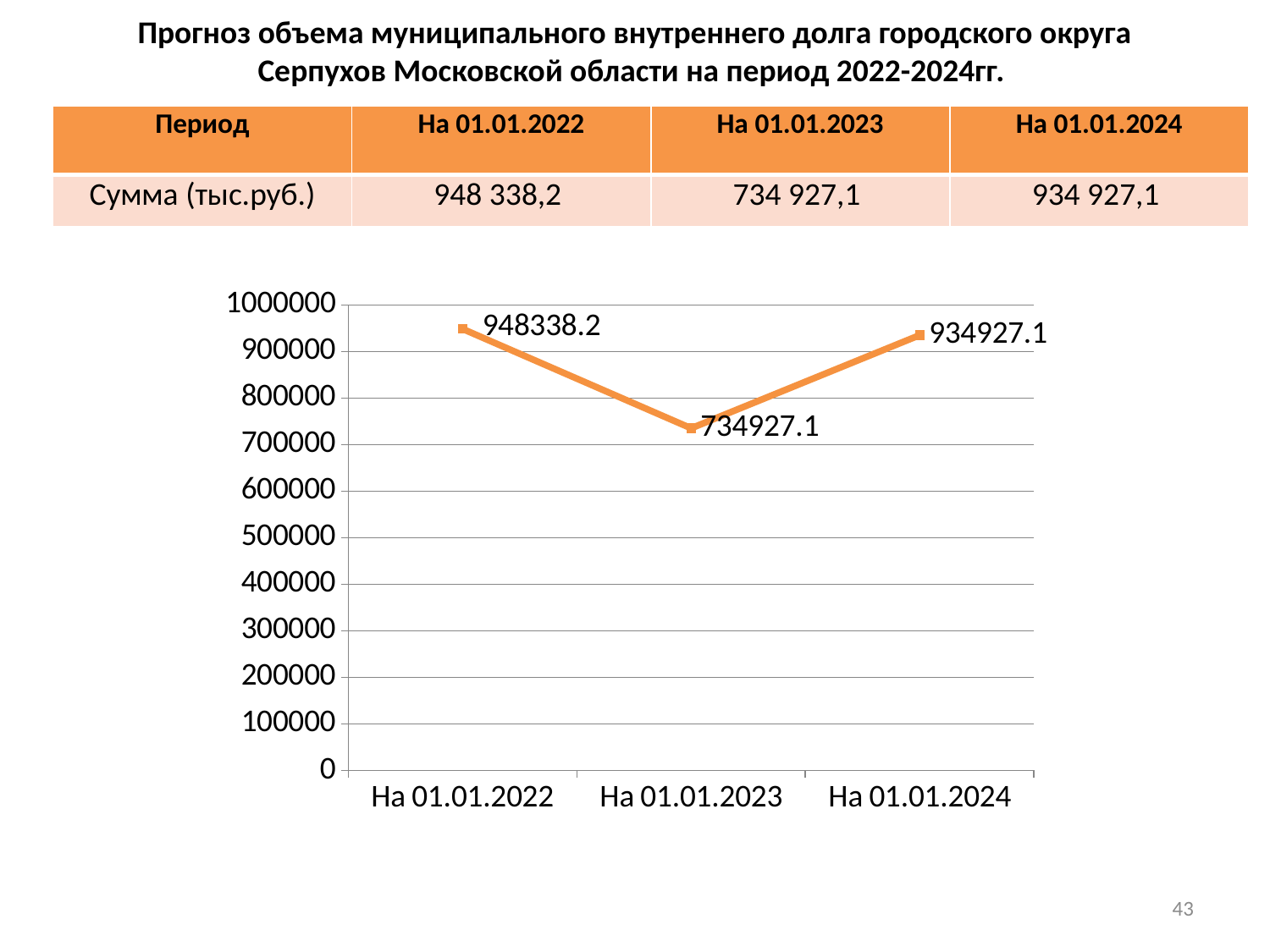
Is the value for На 01.01.2023 greater or less than 800000? less What kind of chart is shown on the slide? line chart Which period has the lowest value on the chart? На 01.01.2023 Which period has the highest value on the chart? На 01.01.2022 What is the value plotted for На 01.01.2024? 934927.1 What is the difference between the values for На 01.01.2022 and На 01.01.2023? 213411.1 Does the value fall or rise from На 01.01.2023 to На 01.01.2024? rise Which is larger, the value for На 01.01.2022 or the value for На 01.01.2024? На 01.01.2022 What is the value plotted for На 01.01.2022? 948338.2 What is the value plotted for На 01.01.2023? 734927.1 What is the difference between the values for На 01.01.2024 and На 01.01.2023? 200000 How many data points are plotted on the chart? 3